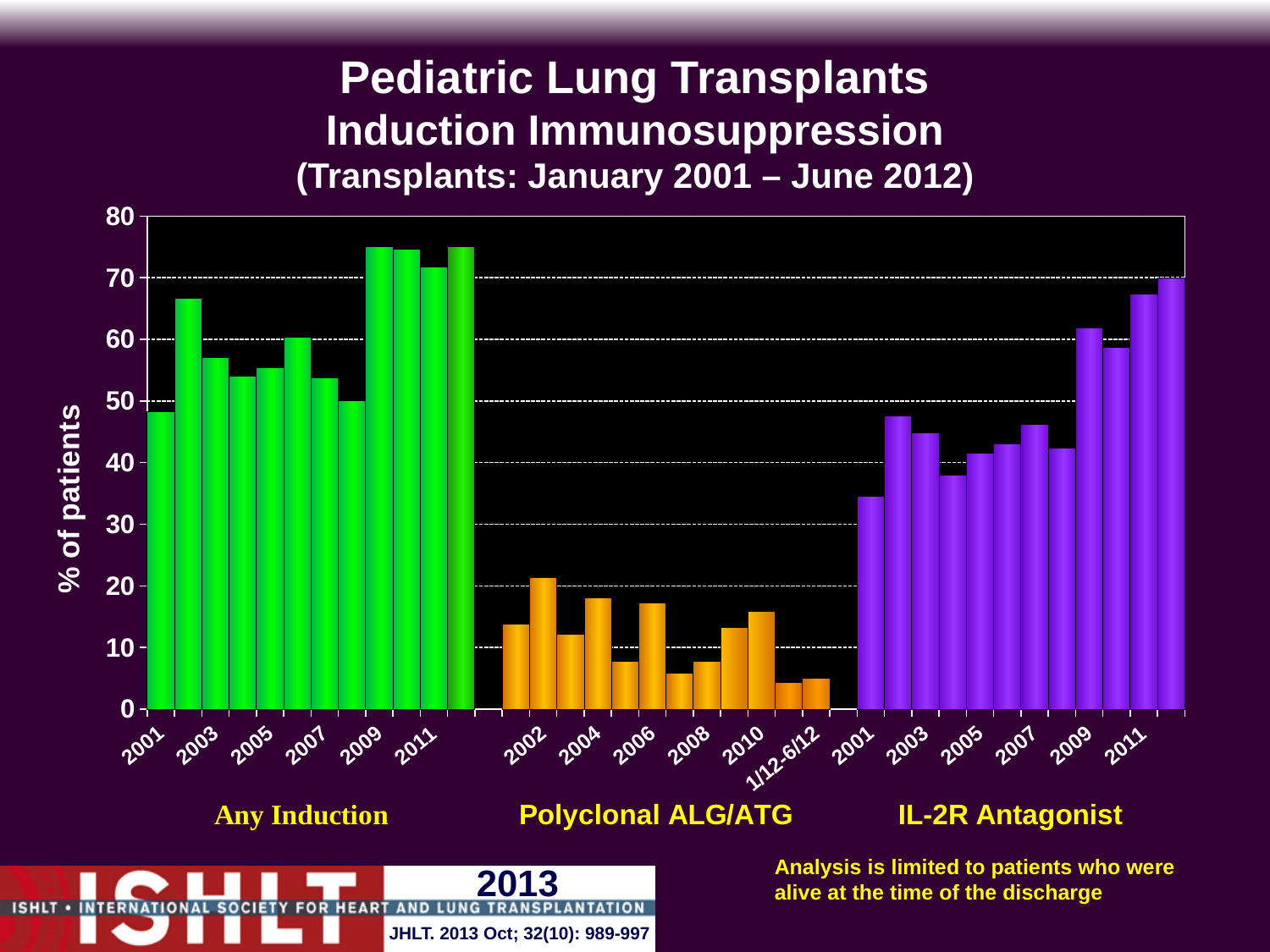
In the Any Induction group, which is larger: the value for 2002 or the value for 2003? 2002 How many induction categories (groups of bars) does the chart show? 3 Is the IL-2R Antagonist value for 2009 greater or less than 60? greater Is the Any Induction value for 2009 greater or less than 70? greater What kind of chart is shown on the slide? bar chart Is the Any Induction value for 2001 greater or less than 50? less How many bars are in the Any Induction group? 12 What is the label on the y axis of the chart? % of patients Which year has the highest value in the Polyclonal ALG/ATG group? 2002 Which year has the lowest value in the IL-2R Antagonist group? 2001